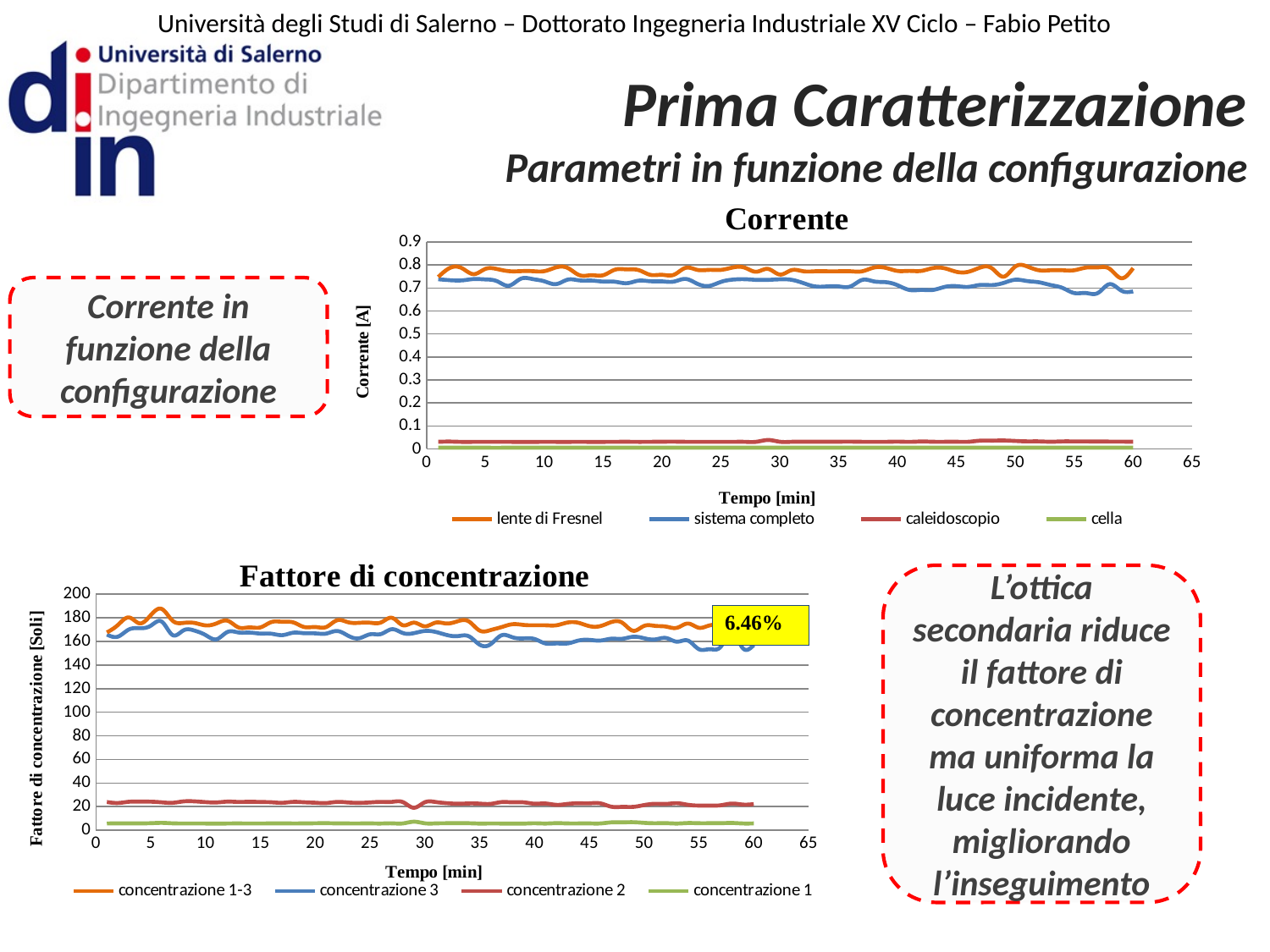
In the "Fattore di concentrazione" chart, is the value for concentrazione 1-3 greater or less than 140? greater In the "Corrente" chart, is the value for caleidoscopio greater or less than 0.1? less What kind of chart is the "Corrente" chart? line chart In the "Corrente" chart, which is larger, sistema completo or caleidoscopio? sistema completo In the "Corrente" chart, which series has the lowest values? cella How many series does the legend of the "Fattore di concentrazione" chart list? 4 In the "Corrente" chart, is the value for lente di Fresnel greater or less than 0.7? greater How many series does the legend of the "Corrente" chart list? 4 What percentage is shown in the yellow label on the "Fattore di concentrazione" chart? 6.46% In the "Corrente" chart, which series has the highest values? lente di Fresnel In the "Fattore di concentrazione" chart, which series has the lowest values? concentrazione 1